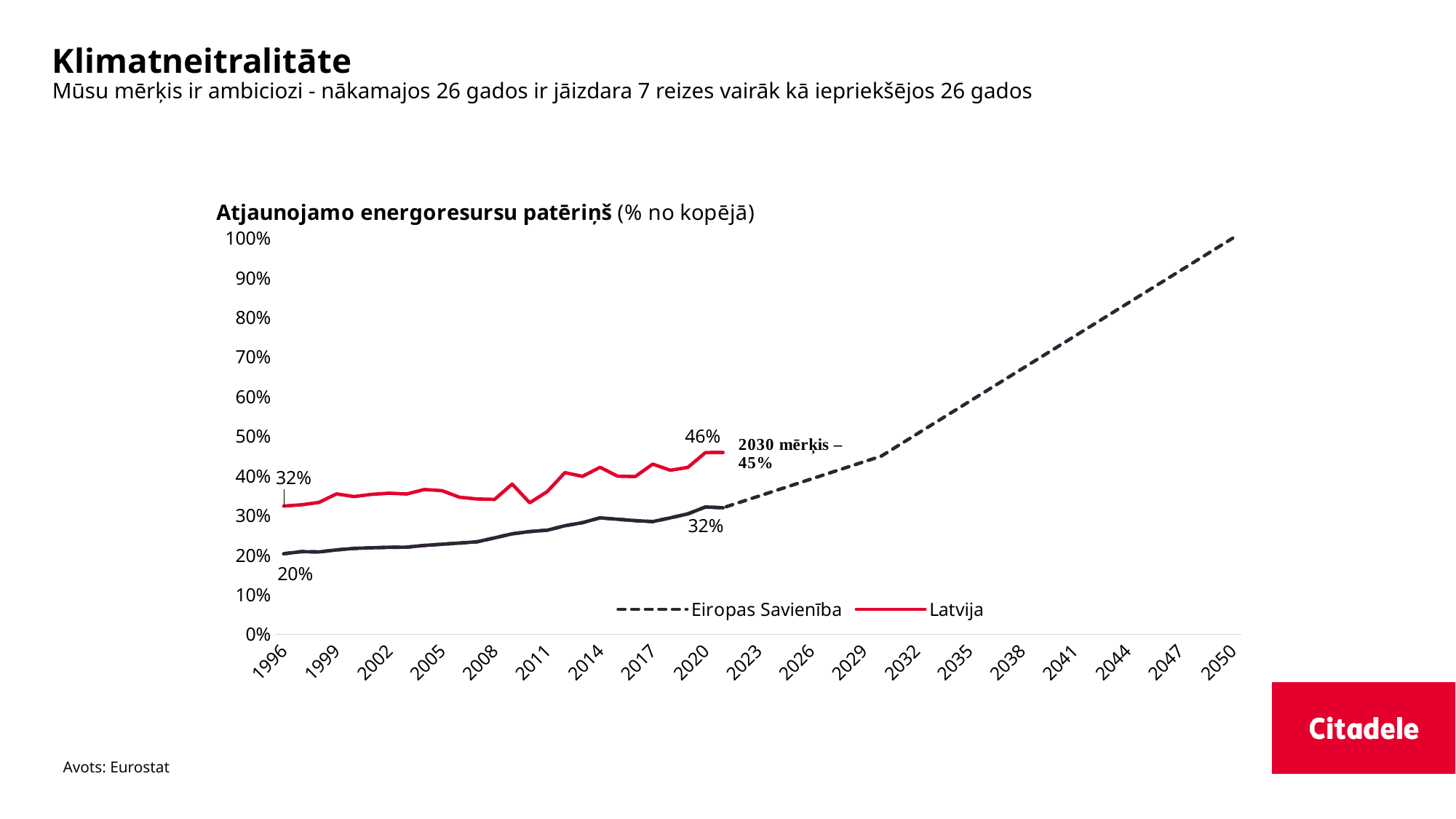
What is the latest labelled value for Latvija on the chart? 46% By how many percentage points did the Latvija value rise from its 1996 label (32%) to its latest label (46%)? 14 percentage points Is the projected Eiropas Savienība value in 2050 greater or less than 90%? greater Does the Eiropas Savienība line rise or fall from 1996 to 2050? Rises How many series does the legend list? 2 What is the value for Latvija at the start of the series in 1996? 32% In 1996, which series had the higher value, Latvija or Eiropas Savienība? Latvija What is the value for Eiropas Savienība at the start of the series in 1996? 20% What kind of chart is shown on the slide? Line chart What is the latest labelled value for Eiropas Savienība on the chart? 32% What 2030 target (2030 mērķis) is annotated on the chart? 45% By how many percentage points did the Eiropas Savienība value rise from its 1996 label (20%) to its latest label (32%)? 12 percentage points